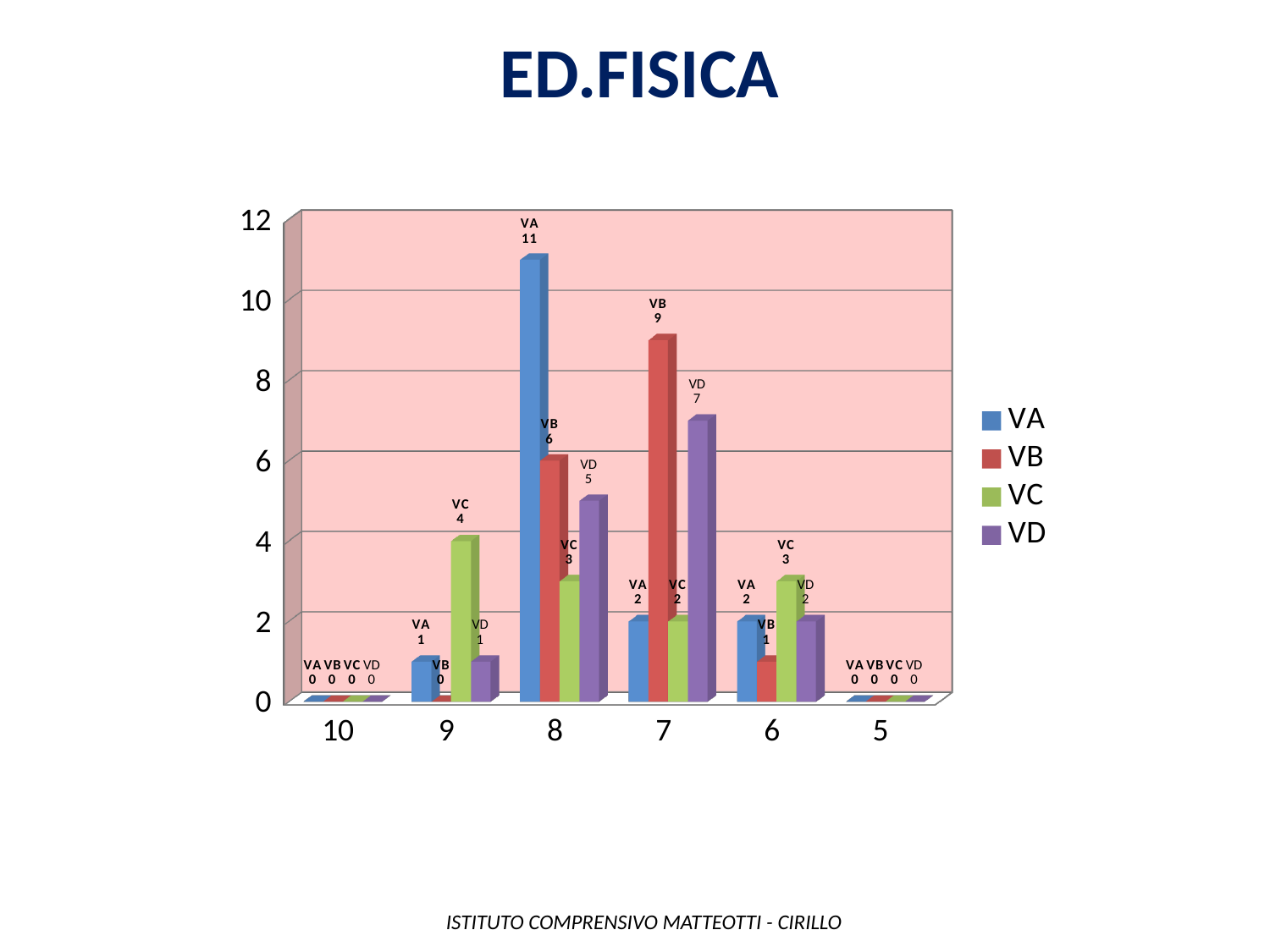
Which category has the highest value for VA? 8 What is the value for VB at category 7? 9 Which category has the highest value for VD? 7 What is the difference between VA and VB at category 8? 5 What is the title of the chart? ED.FISICA What is the value for VC at category 9? 4 How many series does the legend list? 4 Which is larger at category 7: VB or VD? VB What is the value for VA at category 8? 11 What kind of chart is shown on the slide? bar chart What is the value for VD at category 8? 5 How many categories are shown on the x axis? 6